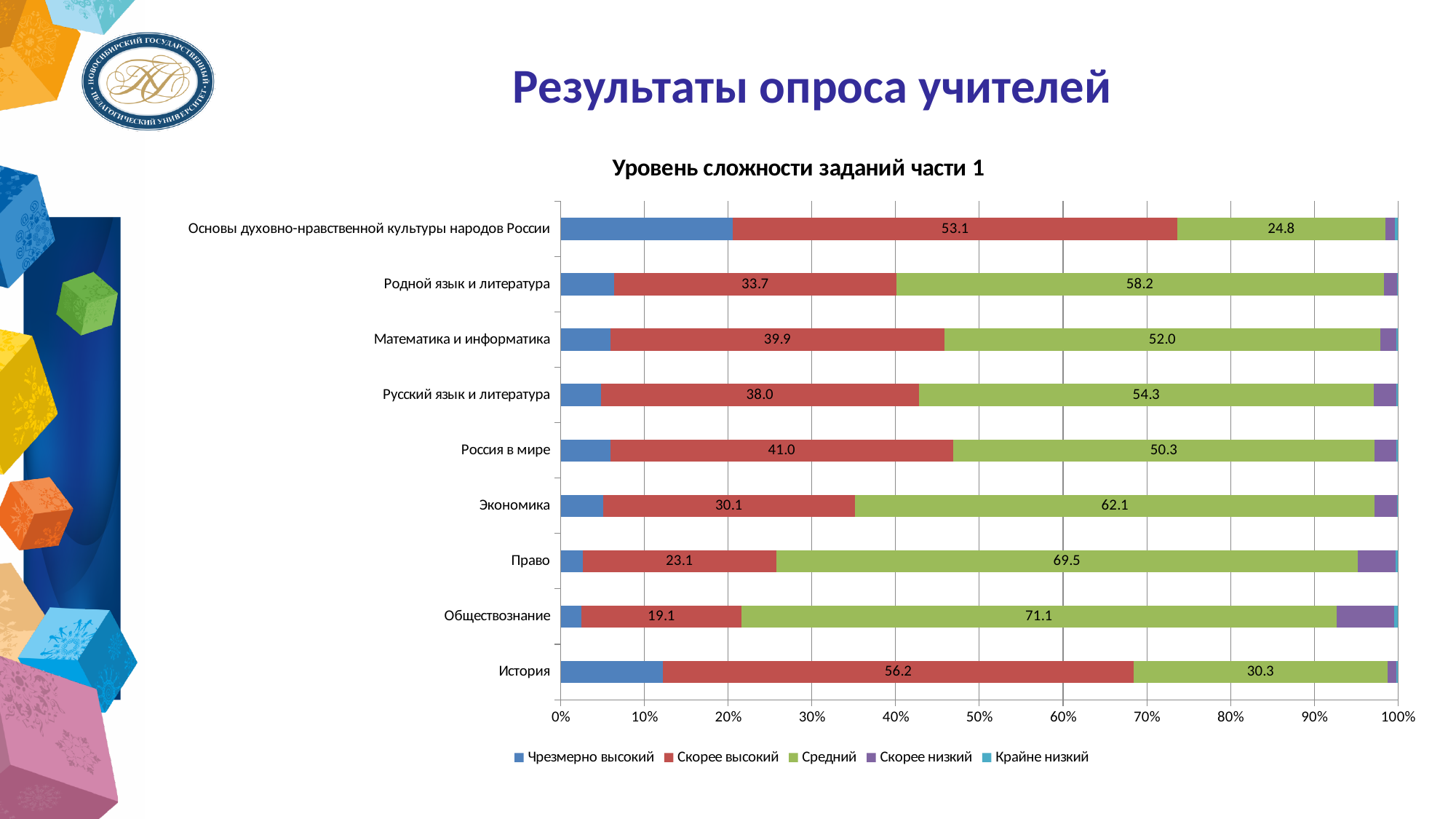
Which has a larger "Средний" value: Экономика or Родной язык и литература? Экономика Which category has the lowest value for the "Средний" series? Основы духовно-нравственной культуры народов России What is the value of the "Средний" series for Право? 69.5 Is the "Чрезмерно высокий" value for История greater or less than 10%? greater What is the value of the "Скорее высокий" series for История? 56.2 What is the value of the "Скорее высокий" series for Экономика? 30.1 How many series does the legend list? 5 Which category has the lowest value for the "Скорее высокий" series? Обществознание How many categories (subjects) are shown on the chart? 9 What kind of chart is shown on the slide? Stacked bar chart What is the difference between the "Средний" and "Скорее высокий" values for Право? 46.4 Which category has the highest value for the "Средний" series? Обществознание